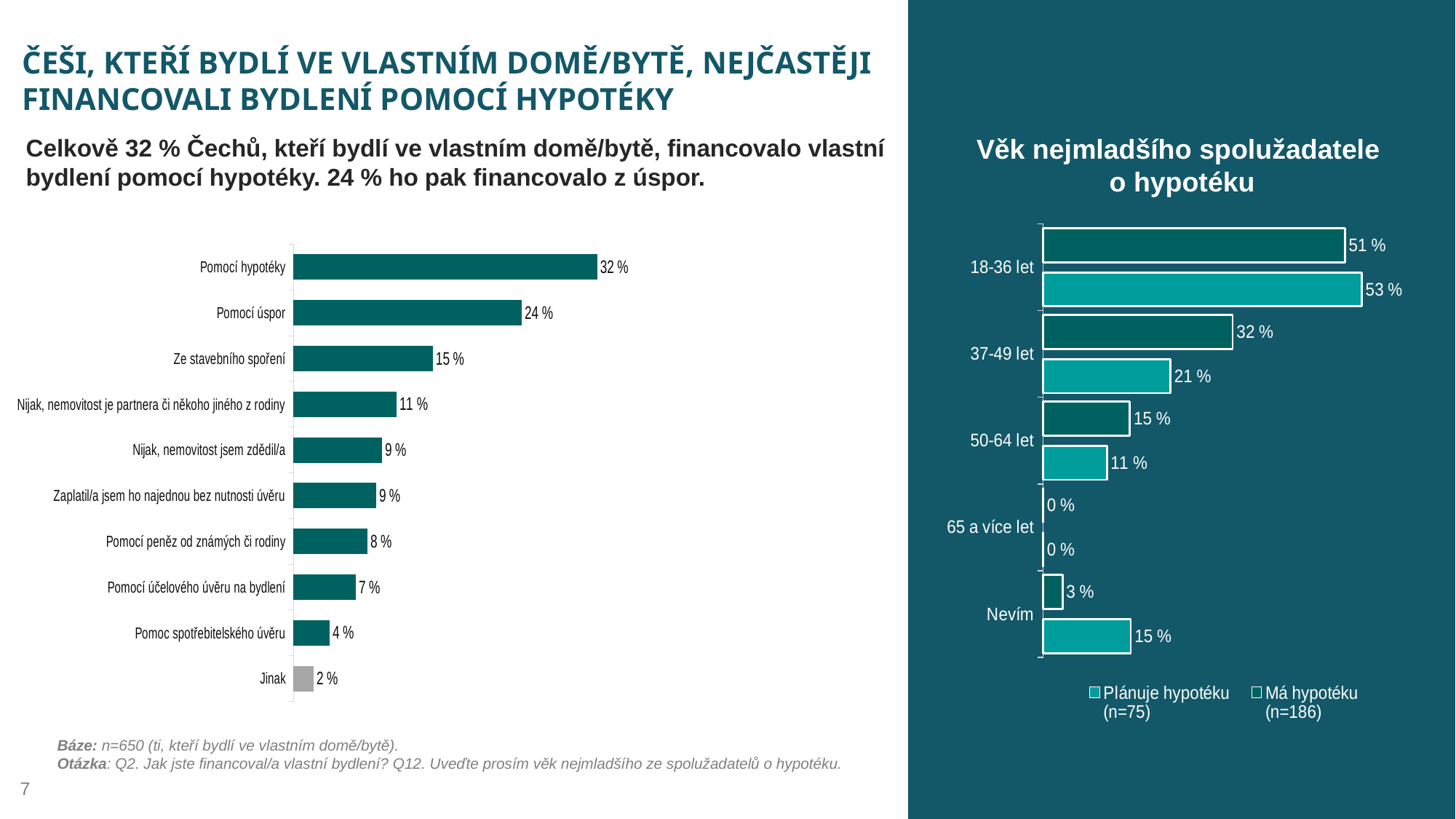
In the chart 'Věk nejmladšího spolužadatele o hypotéku', what is the difference between the two series in the '37-49 let' group? 11 % In the left bar chart, what is the difference between 'Pomocí hypotéky' and 'Pomocí úspor'? 8 % In the chart 'Věk nejmladšího spolužadatele o hypotéku', how many series does the legend list? 2 In the chart 'Věk nejmladšího spolužadatele o hypotéku', what is the value for 'Má hypotéku (n=186)' in the '18-36 let' group? 51 % In the chart 'Věk nejmladšího spolužadatele o hypotéku', what is the value for 'Plánuje hypotéku (n=75)' in the 'Nevím' group? 15 % In the left bar chart, which is larger: 'Pomocí účelového úvěru na bydlení' or 'Pomoc spotřebitelského úvěru'? Pomocí účelového úvěru na bydlení In the chart 'Věk nejmladšího spolužadatele o hypotéku', which age group has the highest value for 'Má hypotéku (n=186)'? 18-36 let In the left bar chart, which category has the lowest value? Jinak In the left bar chart, what is the value for 'Ze stavebního spoření'? 15 % In the left bar chart, what is the value for 'Pomocí hypotéky'? 32 % In the left bar chart, how many categories are shown? 10 What kind of chart is the chart titled 'Věk nejmladšího spolužadatele o hypotéku'? Bar chart